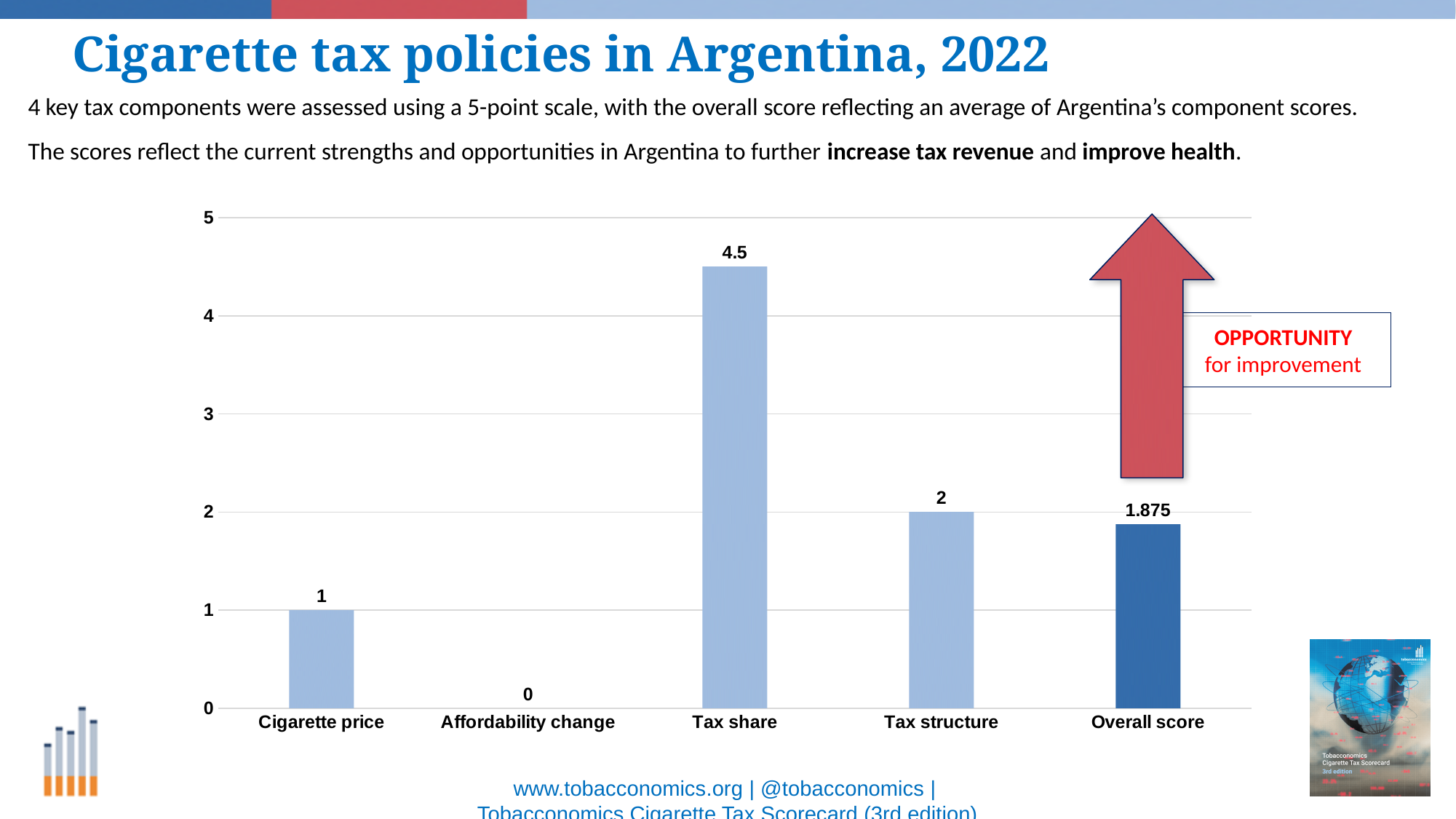
Is the value for Tax share greater or less than 4? greater Which is larger, the value for Tax structure or the value for Cigarette price? Tax structure What is the value for Tax share? 4.5 What is the maximum value shown on the y axis? 5 Which category has the highest value? Tax share What is the value for Cigarette price? 1 What is the difference between the Tax share value and the Tax structure value? 2.5 What is the Overall score? 1.875 Which category has the lowest value? Affordability change What is the value for Affordability change? 0 How many categories are shown on the x axis? 5 What kind of chart is shown on the slide? bar chart